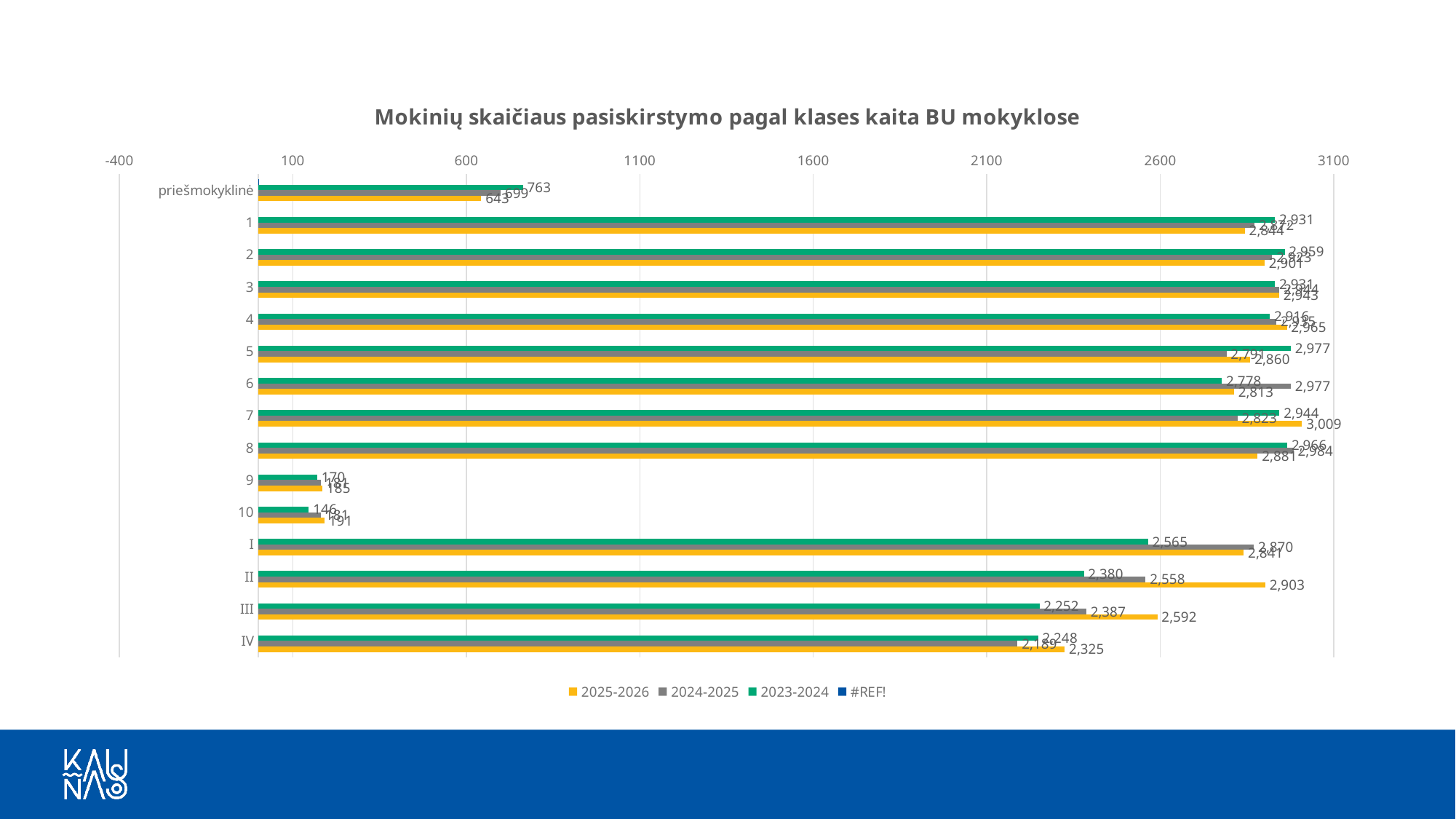
How many categories are plotted on the vertical axis? 15 What is the difference between the 2023-2024 and 2025-2026 values for priešmokyklinė? 120 What is the difference between the 2025-2026 and 2023-2024 values for class II? 523 How many series does the legend list? 4 What is the 2024-2025 value for class II? 2,558 What kind of chart is shown on the slide? bar chart Which category has the highest 2025-2026 value? 7 What is the 2023-2024 value for class 10? 146 For class III, which series has the larger value: 2025-2026 or 2024-2025? 2025-2026 What is the 2025-2026 value for class 7? 3,009 What is the 2023-2024 value for priešmokyklinė? 763 Is the 2025-2026 value for class 9 greater or less than 600? less